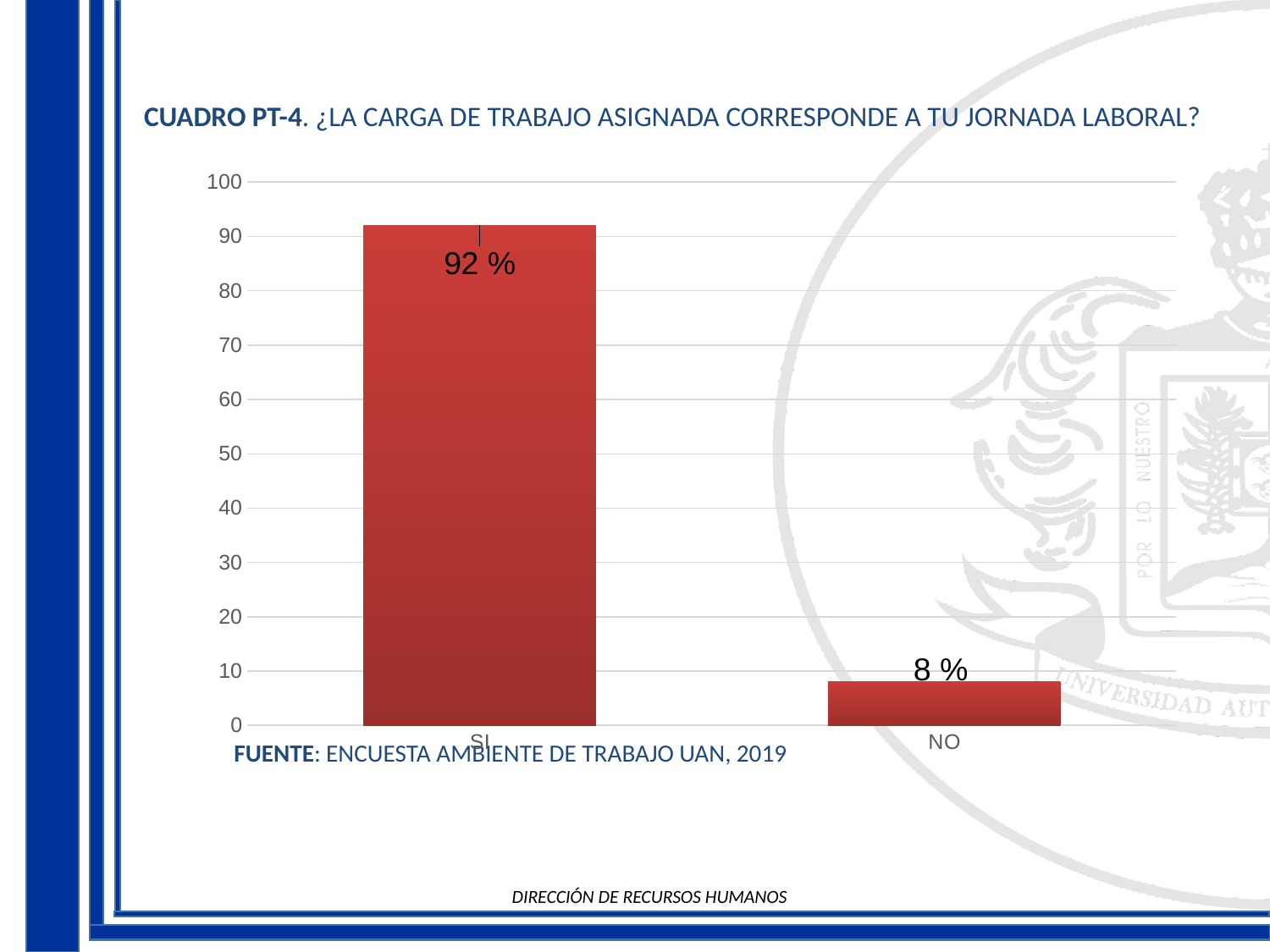
How many categories are shown on the x axis? 2 Is the value for NO greater or less than 10? less What kind of chart is shown on the slide? bar chart Is the value for SI greater or less than 90? greater What colour are the bars in the chart? red What is the value for SI? 92 % What is the source cited below the chart? ENCUESTA AMBIENTE DE TRABAJO UAN, 2019 What is the value for NO? 8 % Which category has the lowest value? NO Which is larger, the value for SI or the value for NO? SI Which category has the highest value? SI What is the difference between the values for SI and NO? 84 %